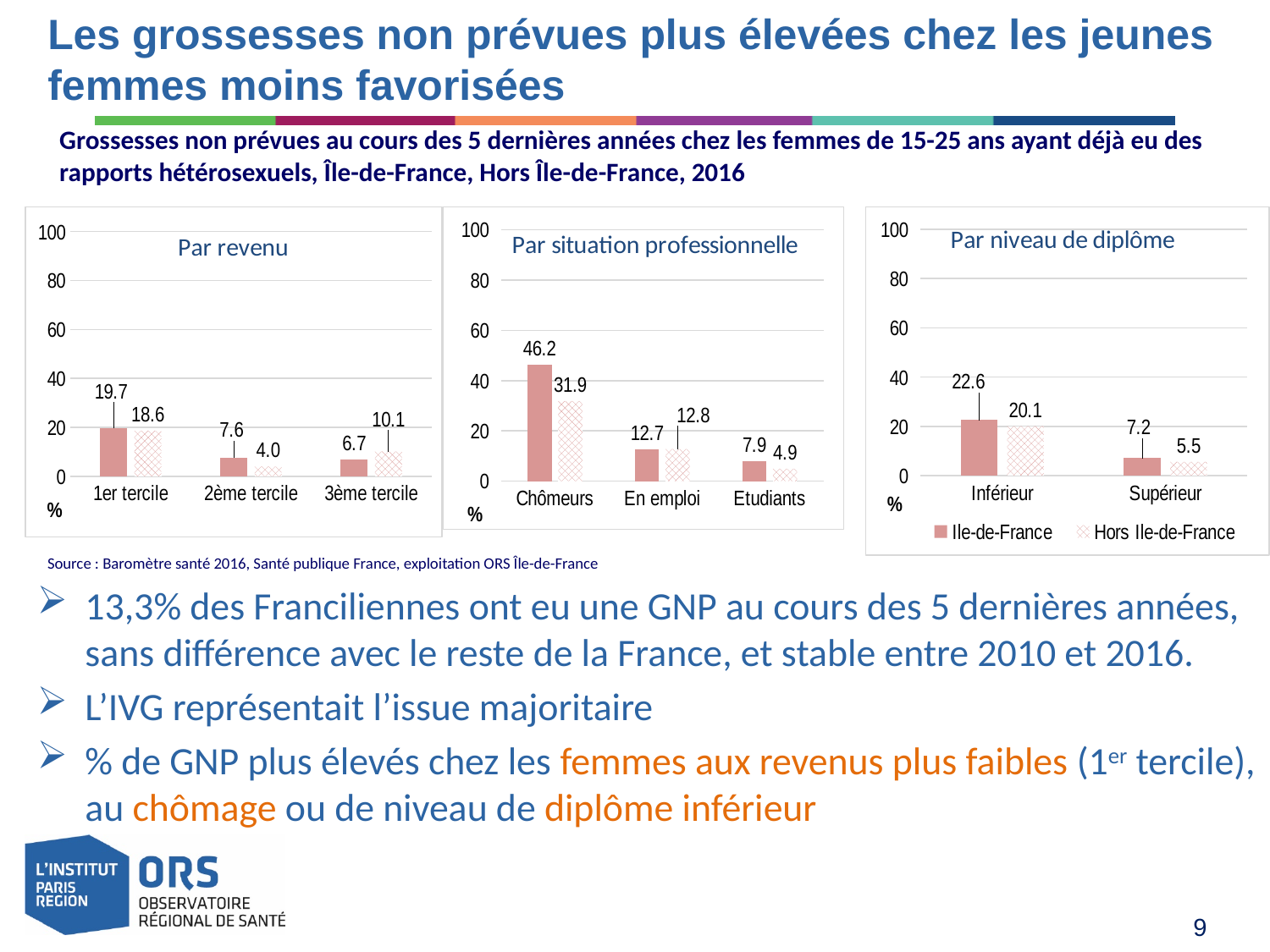
How many categories are shown on the x axis of the 'Par situation professionnelle' chart? 3 In the 'Par revenu' chart, which category has the lowest Ile-de-France value? 3ème tercile In the 'Par situation professionnelle' chart, what is the difference between the Ile-de-France and Hors Ile-de-France values for 'Chômeurs'? 14.3 In the 'Par revenu' chart, what is the value of the Hors Ile-de-France bar for '3ème tercile'? 10.1 In the 'Par niveau de diplôme' chart, what is the value for Hors Ile-de-France in the 'Supérieur' category? 5.5 In the 'Par situation professionnelle' chart, which category has the highest value? Chômeurs In the 'Par revenu' chart, which is larger for '2ème tercile': the Ile-de-France value or the Hors Ile-de-France value? Ile-de-France In the 'Par situation professionnelle' chart, is the Ile-de-France value for 'Chômeurs' greater or less than 40? greater In the 'Par niveau de diplôme' chart, what is the difference between the Ile-de-France values for 'Inférieur' and 'Supérieur'? 15.4 In the 'Par niveau de diplôme' chart, what is the value for Ile-de-France in the 'Inférieur' category? 22.6 How many series does the legend of the 'Par niveau de diplôme' chart list? 2 In the 'Par situation professionnelle' chart, what is the value of the Ile-de-France bar for 'Chômeurs'? 46.2